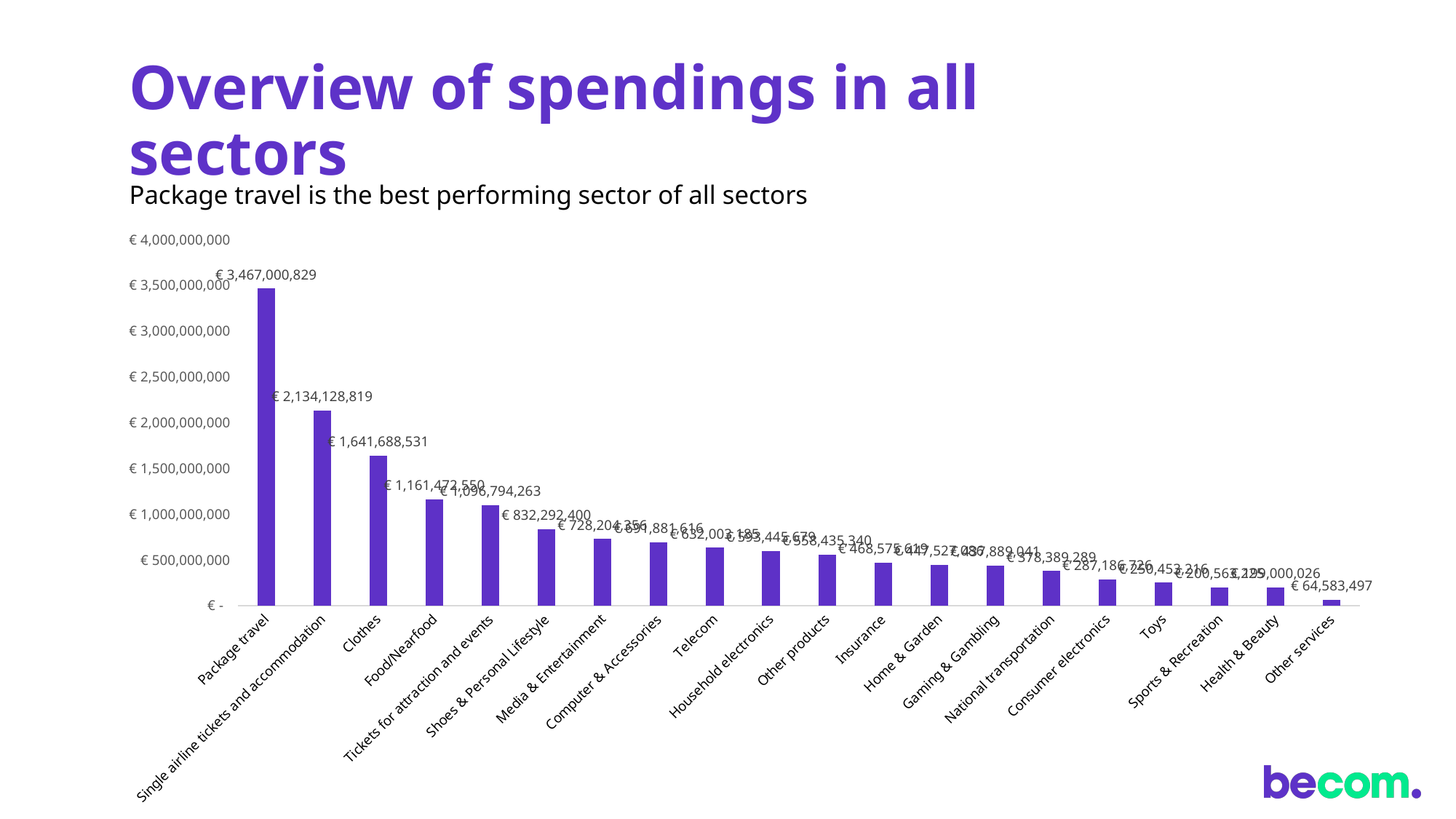
What is the difference between Package travel and Single airline tickets and accommodation? € 1,332,872,010 What is the value for Package travel? € 3,467,000,829 Is the value for Telecom greater or less than € 1,000,000,000? less Which sector has the lowest spending? Other services What is the value for Shoes & Personal Lifestyle? € 832,292,400 What is the value for National transportation? € 378,389,289 What is the value for Other services? € 64,583,497 Do the values rise or fall from left to right along the x axis? fall What is the value for Clothes? € 1,641,688,531 How many sectors are shown on the chart? 20 Which sector has the highest spending? Package travel Which is larger, Clothes or Food/Nearfood? Clothes